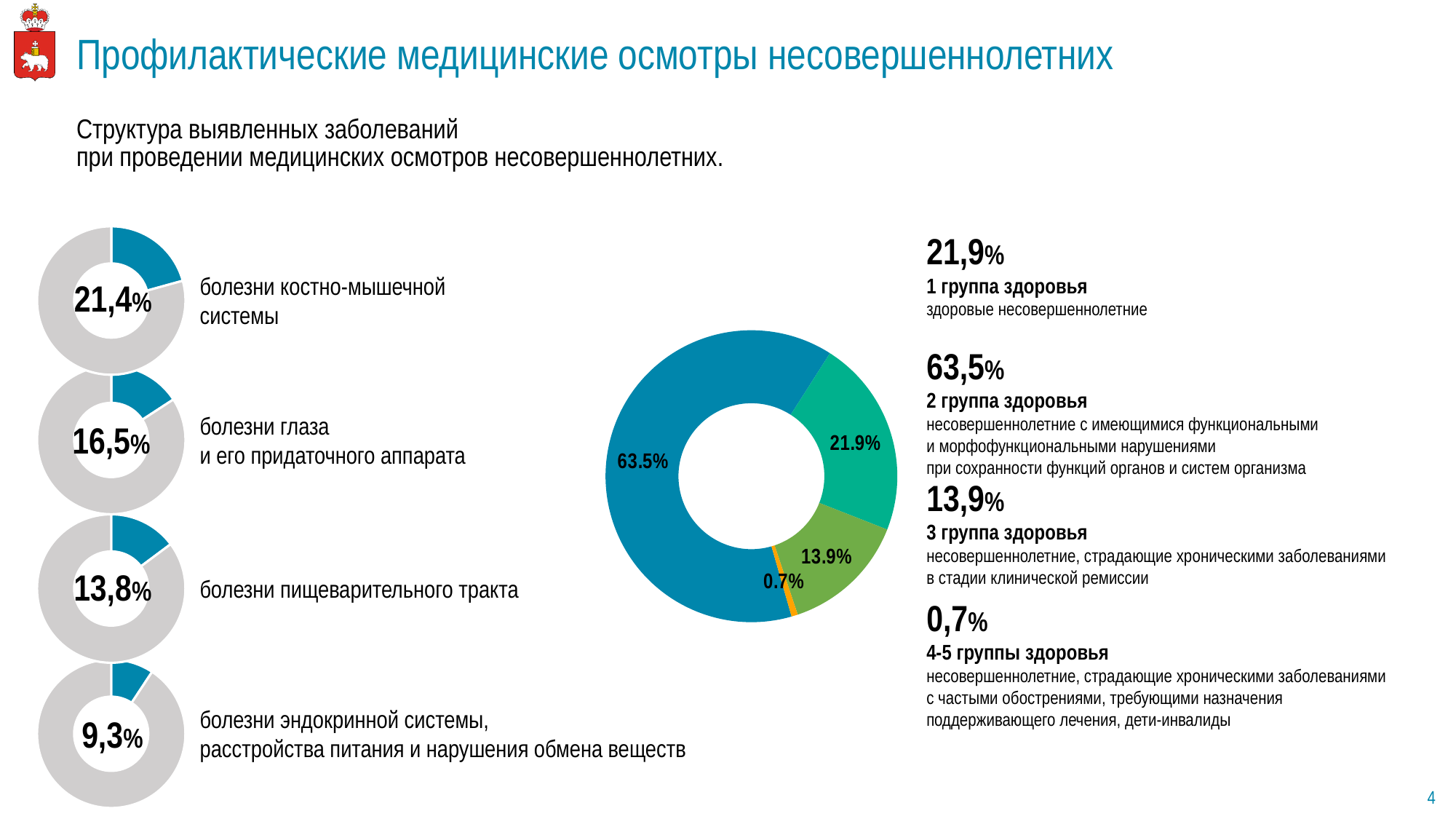
On the central donut chart, what is the combined share of the 13.9% and 0.7% slices? 14.6% On the central donut chart, what colour is the 0.7% slice? Orange On the small donut charts on the left, what is the difference between the value for болезни костно-мышечной системы and the value for болезни пищеварительного тракта? 7,6% On the central donut chart, which slice is larger: the green one labelled 13.9% or the teal one labelled 21.9%? 21.9% On the central donut chart, what is the value of the largest slice? 63.5% On the central donut chart, what is the difference between the 63.5% slice and the 21.9% slice? 41.6% On the central donut chart, what colour is the 63.5% slice? Blue What kind of chart is the large chart in the centre of the slide? Donut (pie) chart On the central donut chart, what is the value of the smallest slice? 0.7% On the small donut charts on the left, which category has the lowest value? болезни эндокринной системы, расстройства питания и нарушения обмена веществ On the small donut charts on the left, what is the value shown for болезни глаза и его придаточного аппарата? 16,5% How many slices does the central donut chart have? 4